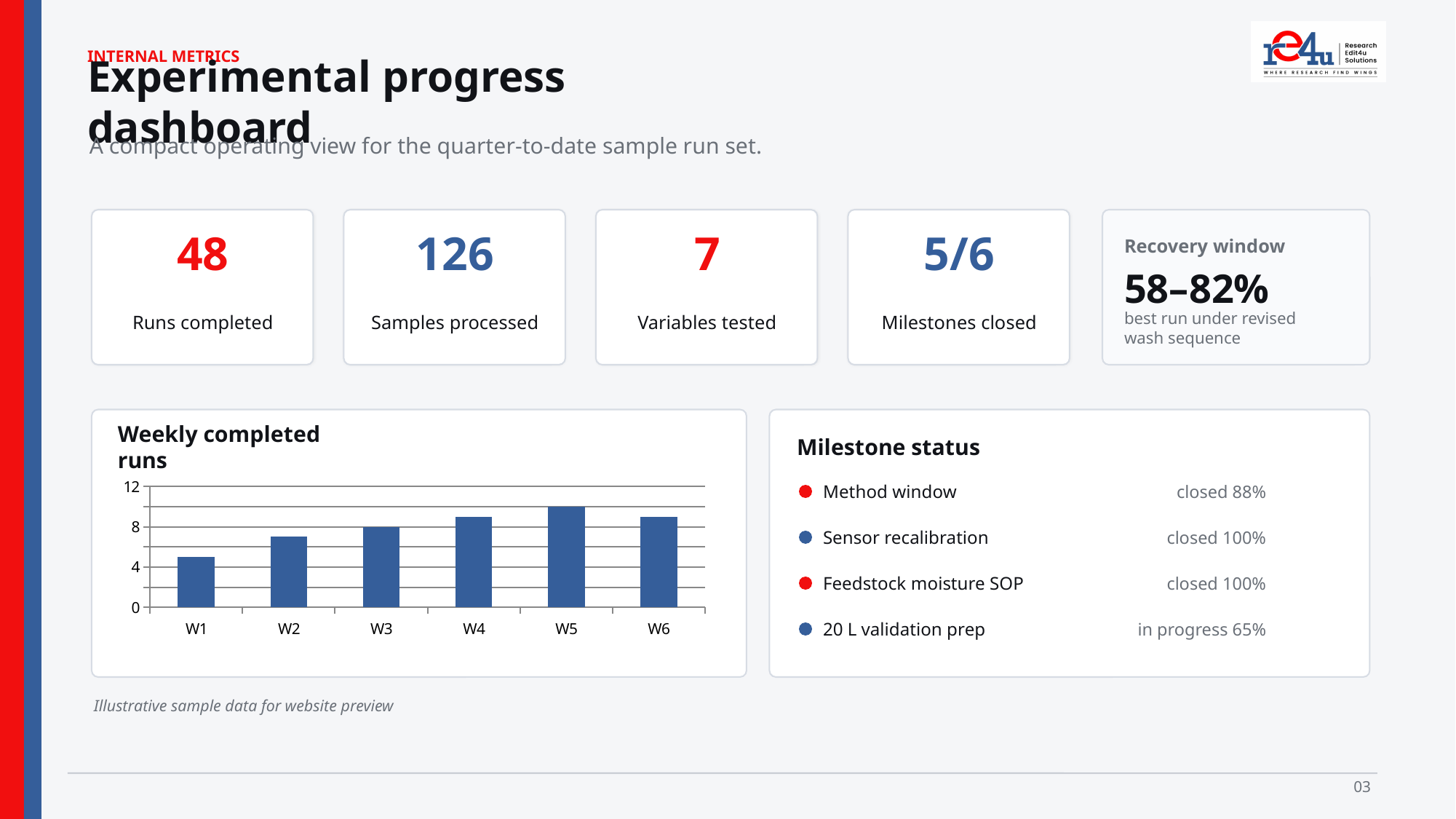
In the Weekly completed runs chart, do the values rise or fall from W1 to W5? rise In the Weekly completed runs chart, which week has the highest number of completed runs? W5 In the Weekly completed runs chart, is the value for W5 greater or less than 8? greater In the Weekly completed runs chart, is the value for W2 greater or less than 8? less In the Weekly completed runs chart, which is larger, the value for W1 or the value for W5? W5 How many weeks are plotted in the Weekly completed runs chart? 6 In the Weekly completed runs chart, is the value for W4 greater or less than 12? less In the Weekly completed runs chart, what is the value for W3? 8 In the Weekly completed runs chart, which week has the lowest number of completed runs? W1 What kind of chart is the Weekly completed runs chart? bar chart What is the title of the bar chart on the slide? Weekly completed runs